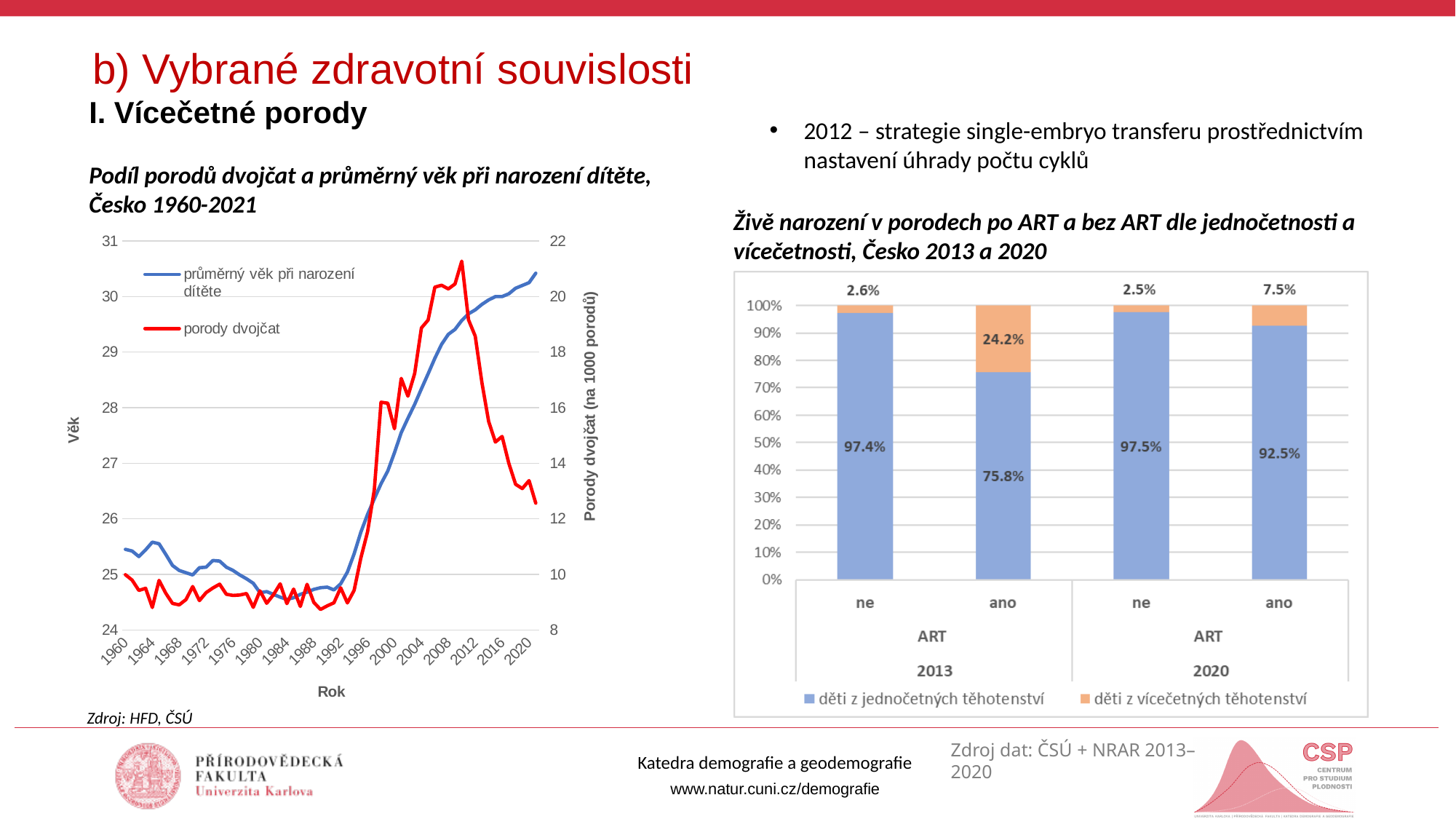
What kind of chart is the left-hand chart (Podíl porodů dvojčat a průměrný věk při narození dítěte)? Line chart In the left-hand chart, is the value of porody dvojčat in 2020 greater or less than 14 (per 1000 births)? less In the right-hand chart, by how many percentage points did the share of children from multiple pregnancies for ART = ano fall between 2013 and 2020? 16.7 percentage points In the right-hand chart, what share of children came from singleton pregnancies for ART = ano in 2020? 92.5% In the right-hand chart, which bar has the highest share of children from multiple pregnancies? ART ano, 2013 In the right-hand chart (Živě narození v porodech po ART a bez ART), what share of children came from multiple pregnancies for ART = ano in 2013? 24.2% In the right-hand chart, how many bars are plotted? 4 In the left-hand chart, how many series does the legend list? 2 In the left-hand chart, does the average age at birth of a child (průměrný věk při narození dítěte) rise or fall between 1992 and 2020? rise In the right-hand chart, which is larger: the share of singleton-pregnancy children for ART = ne in 2013 or for ART = ano in 2013? ART = ne in 2013 (97.4%) In the right-hand chart, what share of children came from multiple pregnancies for ART = ne in 2020? 2.5% In the right-hand chart, how many series does the legend list? 2